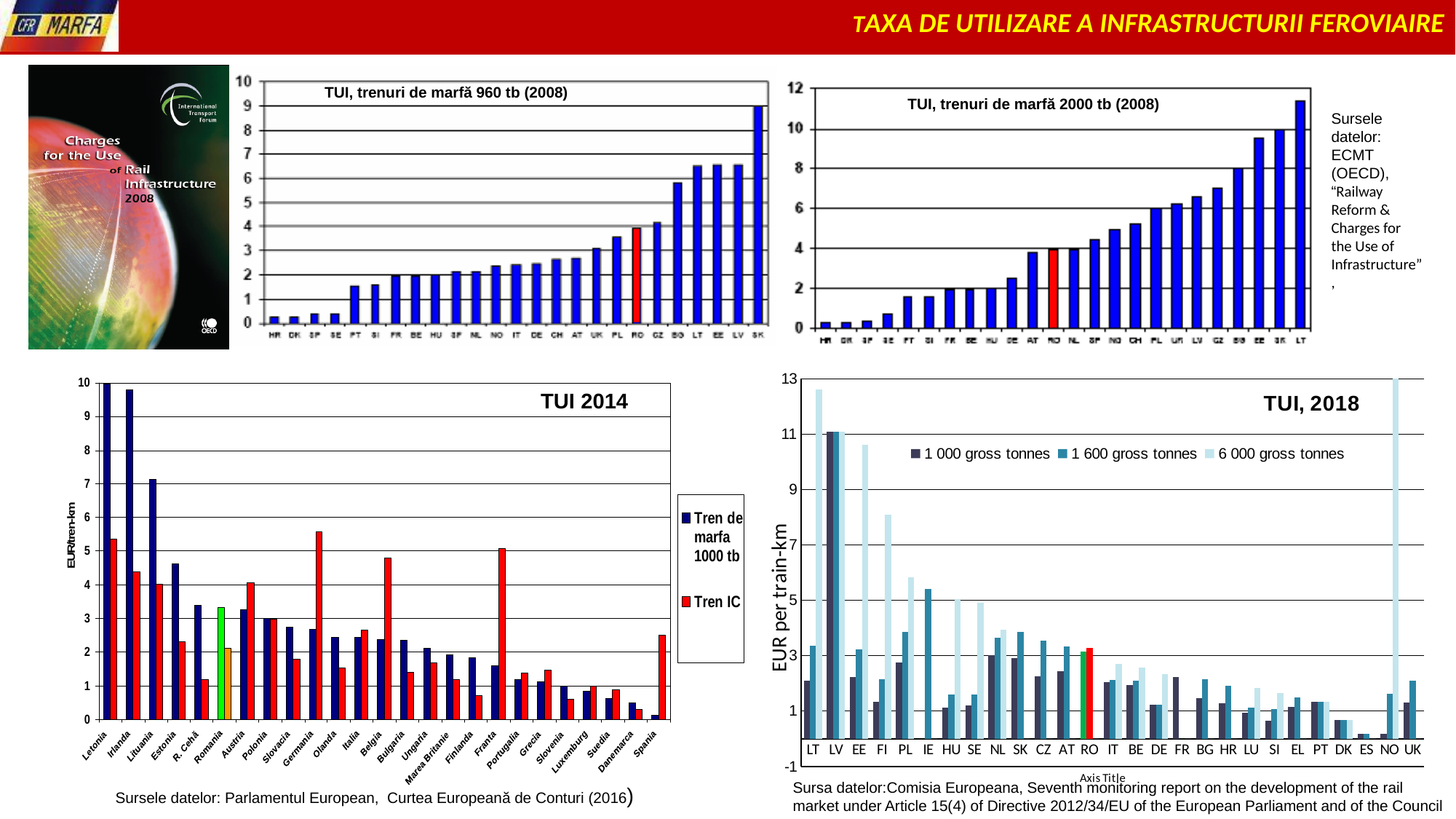
How many series does the legend of the 'TUI, 2018' chart list? 3 In the 'TUI 2014' chart, which country has the highest 'Tren de marfa 1000 tb' value? Letonia In the 'TUI 2014' chart, which is larger for Franta: 'Tren de marfa 1000 tb' or 'Tren IC'? Tren IC In the 'TUI, trenuri de marfă 960 tb (2008)' chart, which country has the highest value? SK In the 'TUI 2014' chart, is the 'Tren IC' value for Germania greater or less than 5? greater In the 'TUI, trenuri de marfă 2000 tb (2008)' chart, which bar is coloured red? RO What kind of chart is the 'TUI, trenuri de marfă 960 tb (2008)' chart at the top of the slide? bar chart In the 'TUI, trenuri de marfă 960 tb (2008)' chart, do the values rise or fall from left to right along the x axis? rise In the 'TUI, trenuri de marfă 2000 tb (2008)' chart, which country has the highest value? LT In the 'TUI, trenuri de marfă 2000 tb (2008)' chart, is the value for LT greater or less than 10? greater In the 'TUI, trenuri de marfă 960 tb (2008)' chart, is the value for SK greater or less than 8? greater How many series does the legend of the 'TUI 2014' chart list? 2